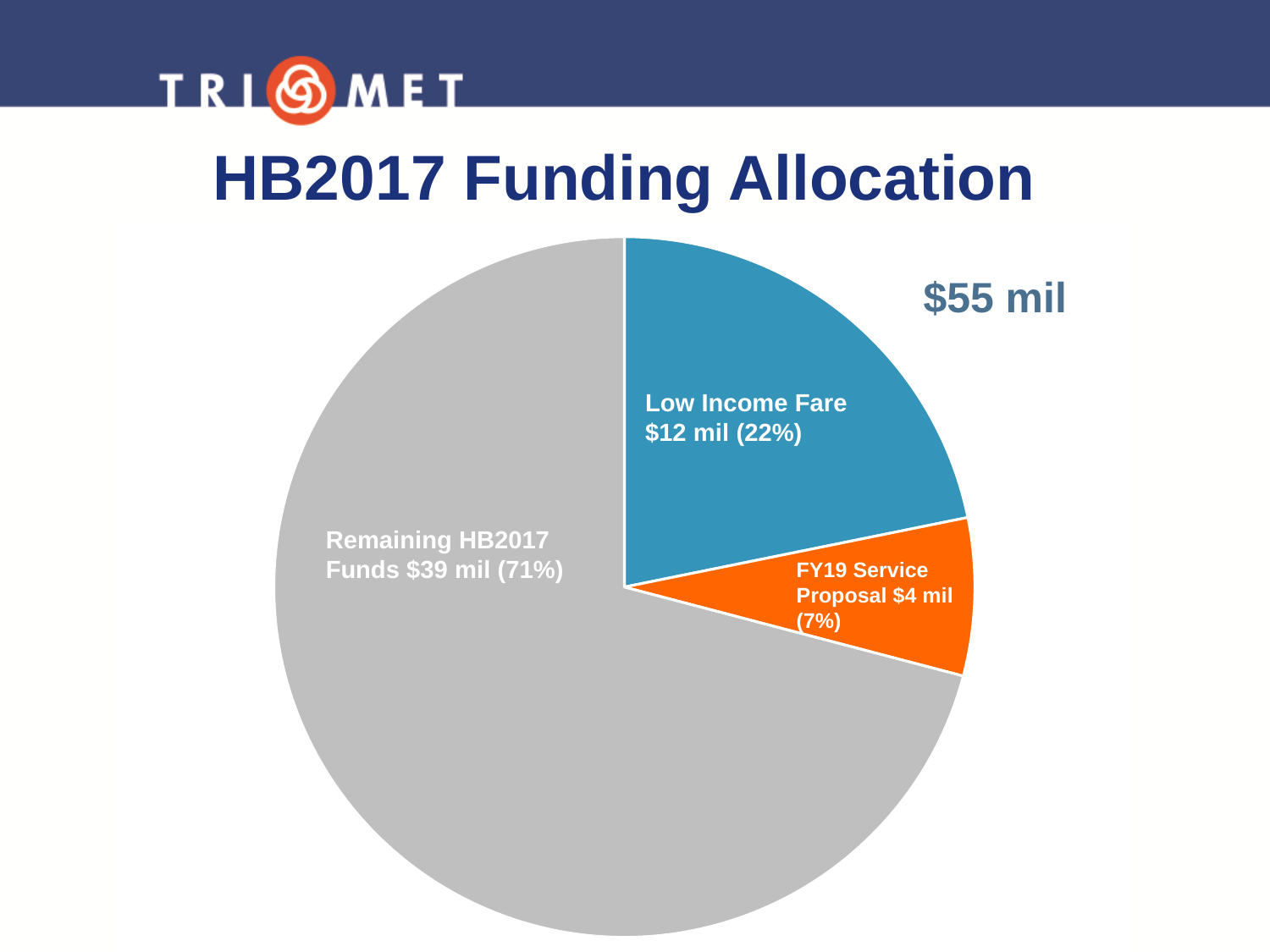
Which slice is the smallest? FY19 Service Proposal What is the value for Remaining HB2017 Funds? $39 mil What is the value for FY19 Service Proposal? $4 mil What is the difference between Low Income Fare and FY19 Service Proposal? $8 mil What total amount is shown next to the pie chart? $55 mil What kind of chart is shown on the slide? pie chart What share of the pie does Low Income Fare represent? 22% How many slices does the pie chart have? 3 What is the title of the chart? HB2017 Funding Allocation What share of the pie does Remaining HB2017 Funds represent? 71% What is the value for Low Income Fare? $12 mil Which slice is the largest? Remaining HB2017 Funds